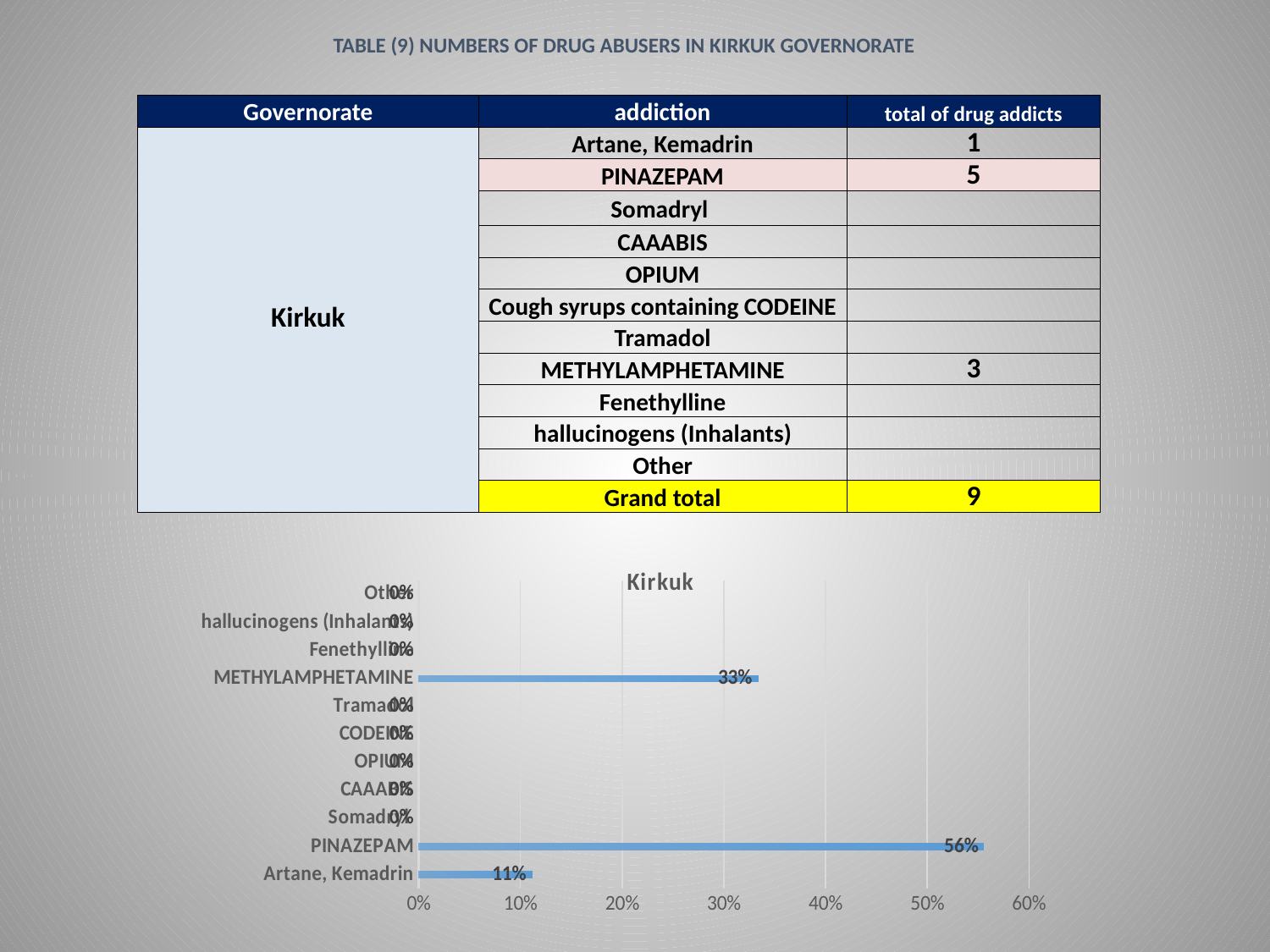
How many categories are shown in the chart? 11 Which category has the highest value in the chart? PINAZEPAM Which is larger, the value for METHYLAMPHETAMINE or the value for Artane, Kemadrin? METHYLAMPHETAMINE What is the difference between the values for PINAZEPAM and METHYLAMPHETAMINE? 23% What is the value for PINAZEPAM in the chart? 56% What type of chart is shown on the slide? bar chart What is the difference between the values for METHYLAMPHETAMINE and Artane, Kemadrin? 22% Is the value for PINAZEPAM greater or less than 50%? greater What is the value for Artane, Kemadrin in the chart? 11% What is the value for METHYLAMPHETAMINE in the chart? 33% What is the title of the chart? Kirkuk What is the value for OPIUM in the chart? 0%